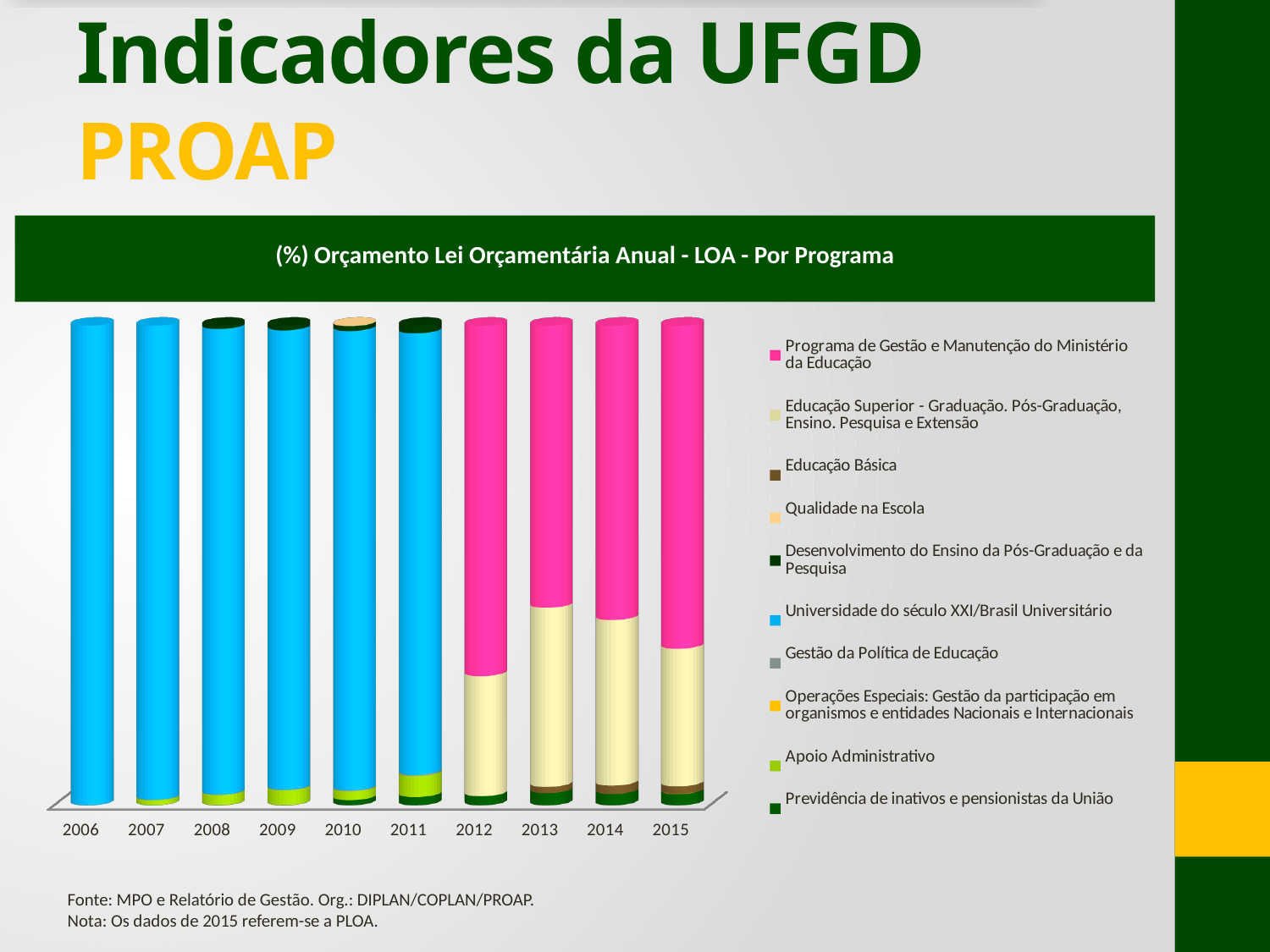
Among the years 2012 to 2015, which year has the smallest Educação Superior (cream) segment? 2012 In 2012, which segment is larger: Programa de Gestão e Manutenção do Ministério da Educação (pink) or Educação Superior (cream)? Programa de Gestão e Manutenção do Ministério da Educação Which is the last year in which the bar is dominated by the blue series (Universidade do século XXI/Brasil Universitário)? 2011 How many series does the chart legend list? 10 What is the title of the chart? (%) Orçamento Lei Orçamentária Anual - LOA - Por Programa Does the Apoio Administrativo (light green) segment rise or fall from 2007 to 2011? Rise How many years are shown on the x axis of the chart? 10 Among the years 2006 to 2011, which year has the largest Apoio Administrativo (light green) segment? 2011 In 2015, which segment is larger: Programa de Gestão e Manutenção do Ministério da Educação (pink) or Educação Superior (cream)? Programa de Gestão e Manutenção do Ministério da Educação Which is the first year in which the bar is dominated by the pink series (Programa de Gestão e Manutenção do Ministério da Educação)? 2012 Which series is shown in pink in the chart? Programa de Gestão e Manutenção do Ministério da Educação What kind of chart is shown on the slide? Stacked bar chart